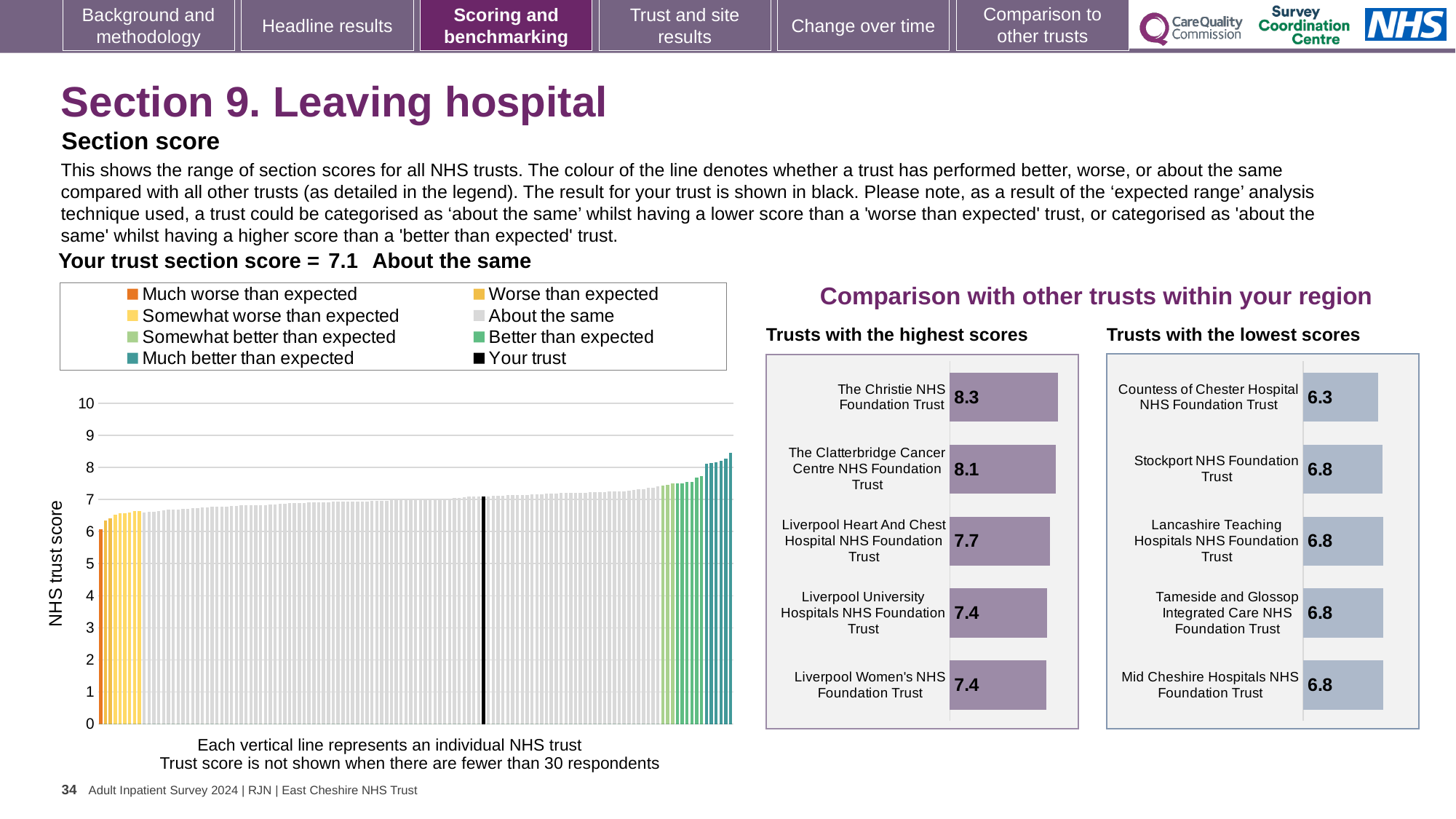
How many entries does the legend of the NHS trust score chart on the left list? 8 How many trusts are shown in the 'Trusts with the lowest scores' chart? 5 In the 'Trusts with the highest scores' chart, which trust has the highest score? The Christie NHS Foundation Trust In the 'Trusts with the highest scores' chart, what is the difference between the scores of The Christie NHS Foundation Trust and Liverpool Women's NHS Foundation Trust? 0.9 In the 'Trusts with the lowest scores' chart, what is the score for Countess of Chester Hospital NHS Foundation Trust? 6.3 In the 'Trusts with the highest scores' chart, what is the score for Liverpool Heart And Chest Hospital NHS Foundation Trust? 7.7 In the NHS trust score chart on the left, do the values rise or fall from left to right? Rise In the 'Trusts with the lowest scores' chart, what is the difference between the scores of Stockport NHS Foundation Trust and Countess of Chester Hospital NHS Foundation Trust? 0.5 In the 'Trusts with the highest scores' chart, what is the score for The Christie NHS Foundation Trust? 8.3 What kind of chart is the NHS trust score chart on the left of the slide? Bar chart In the 'Trusts with the lowest scores' chart, which trust has the lowest score? Countess of Chester Hospital NHS Foundation Trust In the 'Trusts with the highest scores' chart, which has the larger score: The Clatterbridge Cancer Centre NHS Foundation Trust or Liverpool University Hospitals NHS Foundation Trust? The Clatterbridge Cancer Centre NHS Foundation Trust